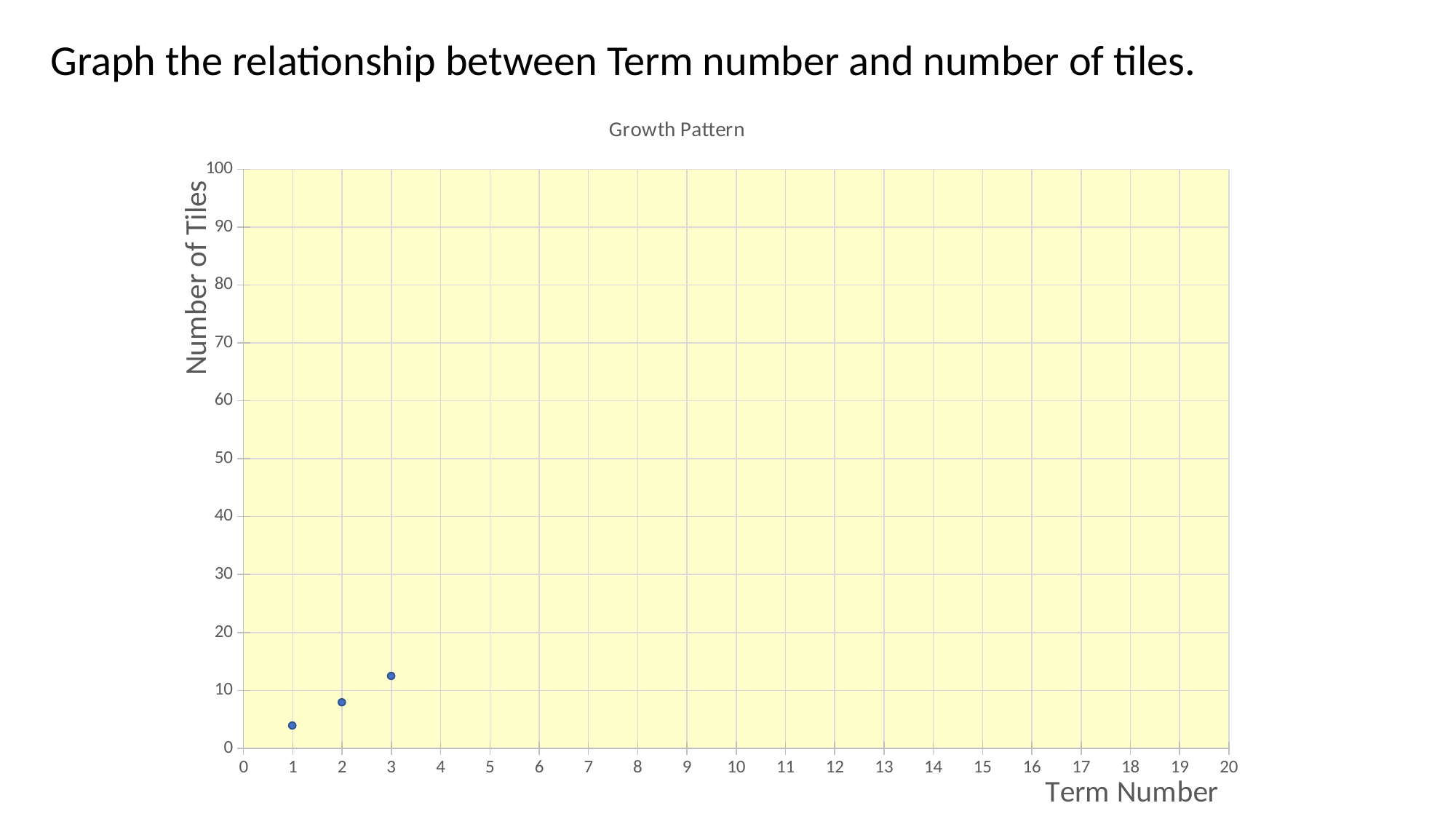
How many data points are plotted on the chart? 3 Do the plotted values rise or fall as the term number increases? rise Which term number has the lowest number of tiles? 1 Is the number of tiles for term 3 greater or less than 20? less What is the label on the vertical axis of the chart? Number of Tiles Is the number of tiles for term 1 greater or less than 10? less Is the number of tiles for term 2 greater or less than 10? less What kind of chart is shown on the slide? scatter chart Which has more tiles, term 1 or term 3? term 3 Which term number has the highest number of tiles? 3 What is the title of the chart? Growth Pattern